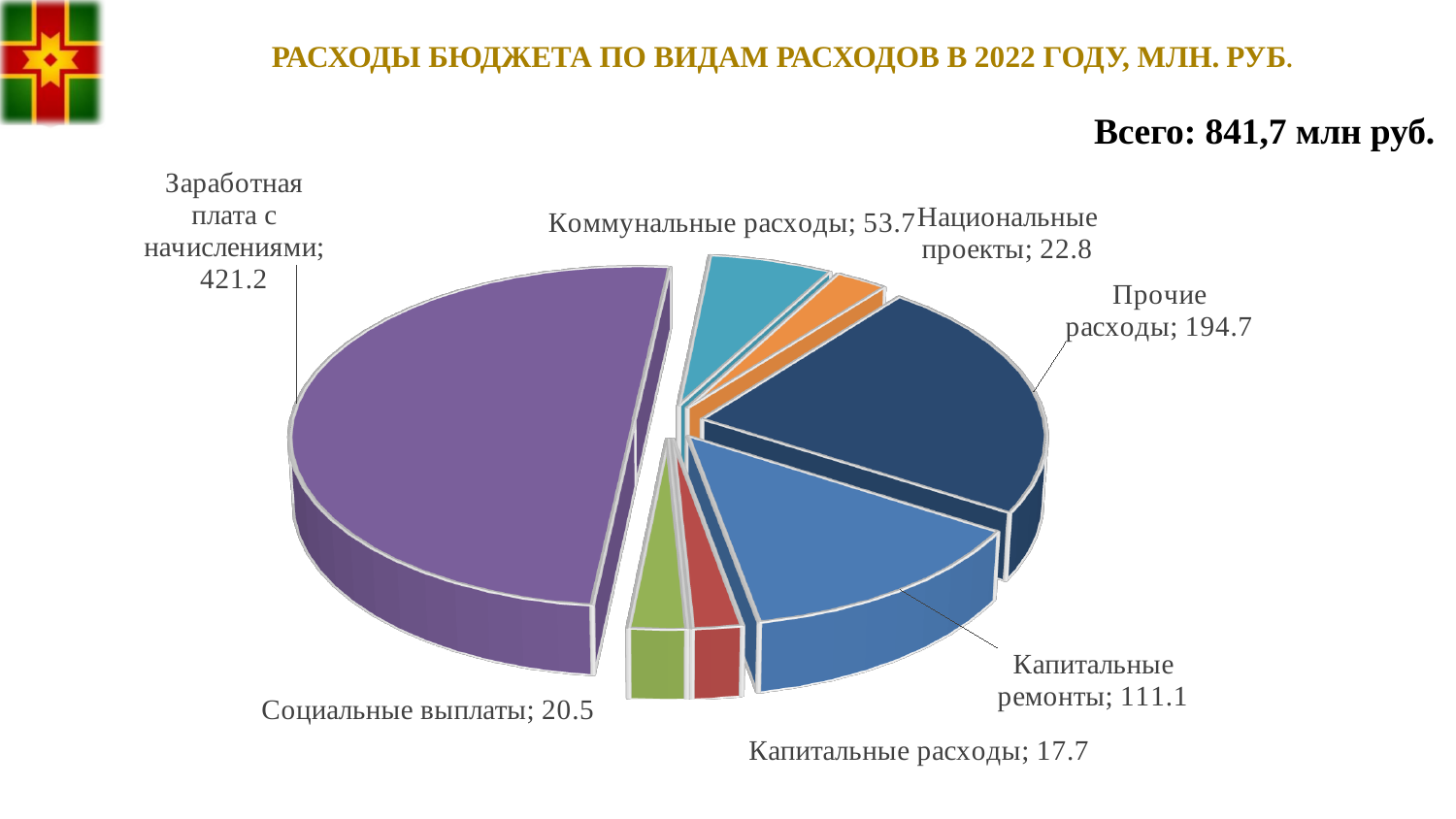
How many categories are shown in the pie chart? 7 What is the value for Национальные проекты? 22.8 What is the value for Заработная плата с начислениями? 421.2 What is the value for Прочие расходы? 194.7 Which category has the smallest value? Капитальные расходы Which category has the largest value? Заработная плата с начислениями What is the difference between Заработная плата с начислениями and Прочие расходы? 226.5 What is the difference between Капитальные ремонты and Коммунальные расходы? 57.4 Which is larger, Социальные выплаты or Капитальные расходы? Социальные выплаты What total amount is stated on the slide? 841,7 млн руб. What is the value for Капитальные ремонты? 111.1 What type of chart is shown on the slide? Pie chart